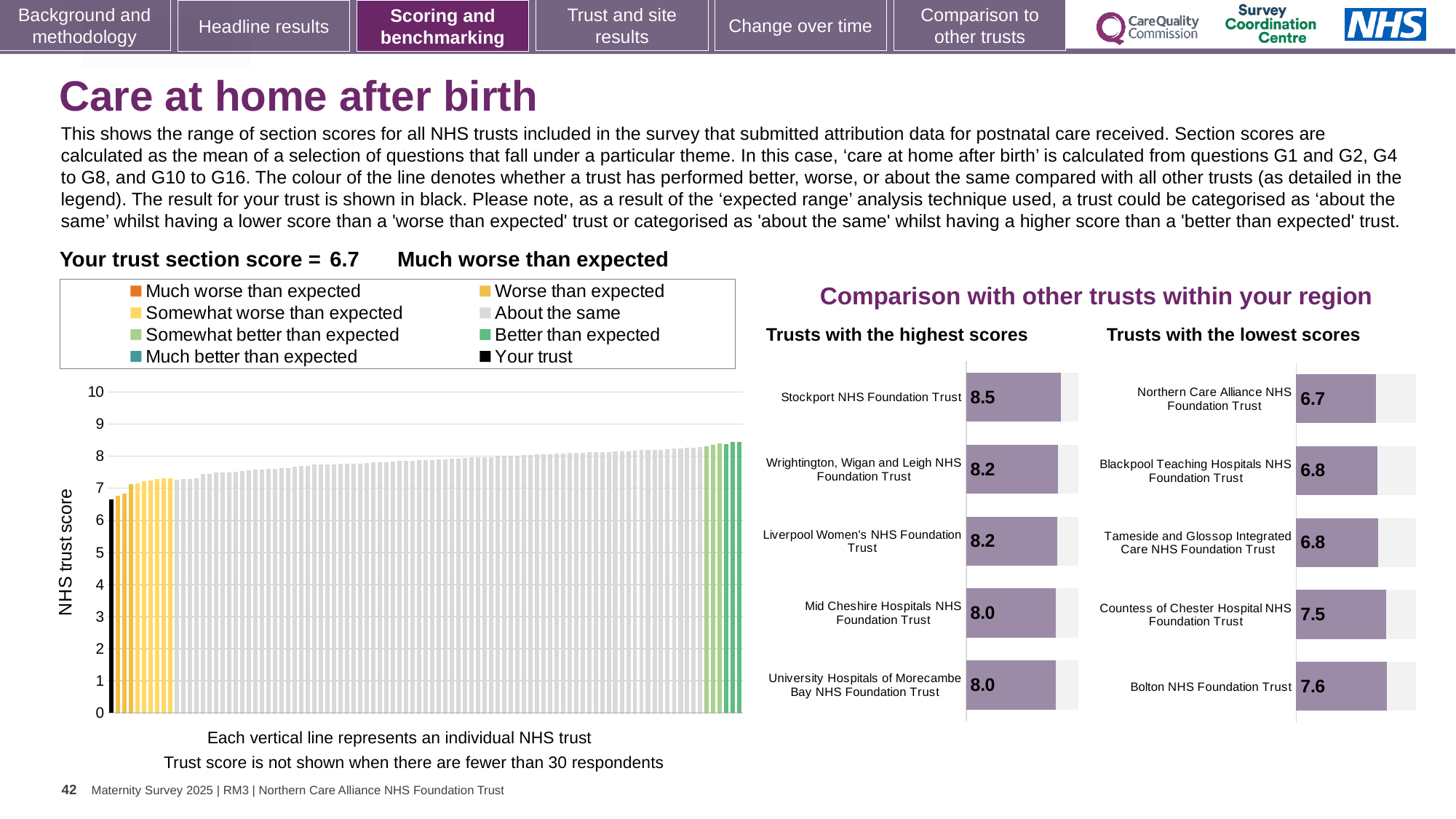
How many entries does the legend above the large chart on the left list? 8 In the 'Trusts with the highest scores' chart, what is the difference between the scores of Stockport NHS Foundation Trust and University Hospitals of Morecambe Bay NHS Foundation Trust? 0.5 In the large chart on the left, do the trust scores rise or fall from left to right? Rise What kind of chart is the large chart on the left showing NHS trust scores? Bar chart In the 'Trusts with the highest scores' chart, which trust has the highest score? Stockport NHS Foundation Trust In the 'Trusts with the lowest scores' chart, which has the larger score: Countess of Chester Hospital NHS Foundation Trust or Tameside and Glossop Integrated Care NHS Foundation Trust? Countess of Chester Hospital NHS Foundation Trust In the large chart on the left, is the value for the black 'Your trust' bar greater or less than 7? less In the 'Trusts with the lowest scores' chart, which trust has the lowest score? Northern Care Alliance NHS Foundation Trust What is the label on the vertical axis of the large chart on the left? NHS trust score In the 'Trusts with the lowest scores' chart, what is the score for Bolton NHS Foundation Trust? 7.6 In the 'Trusts with the highest scores' chart, what is the score for Stockport NHS Foundation Trust? 8.5 How many trusts are shown in the 'Trusts with the highest scores' chart? 5